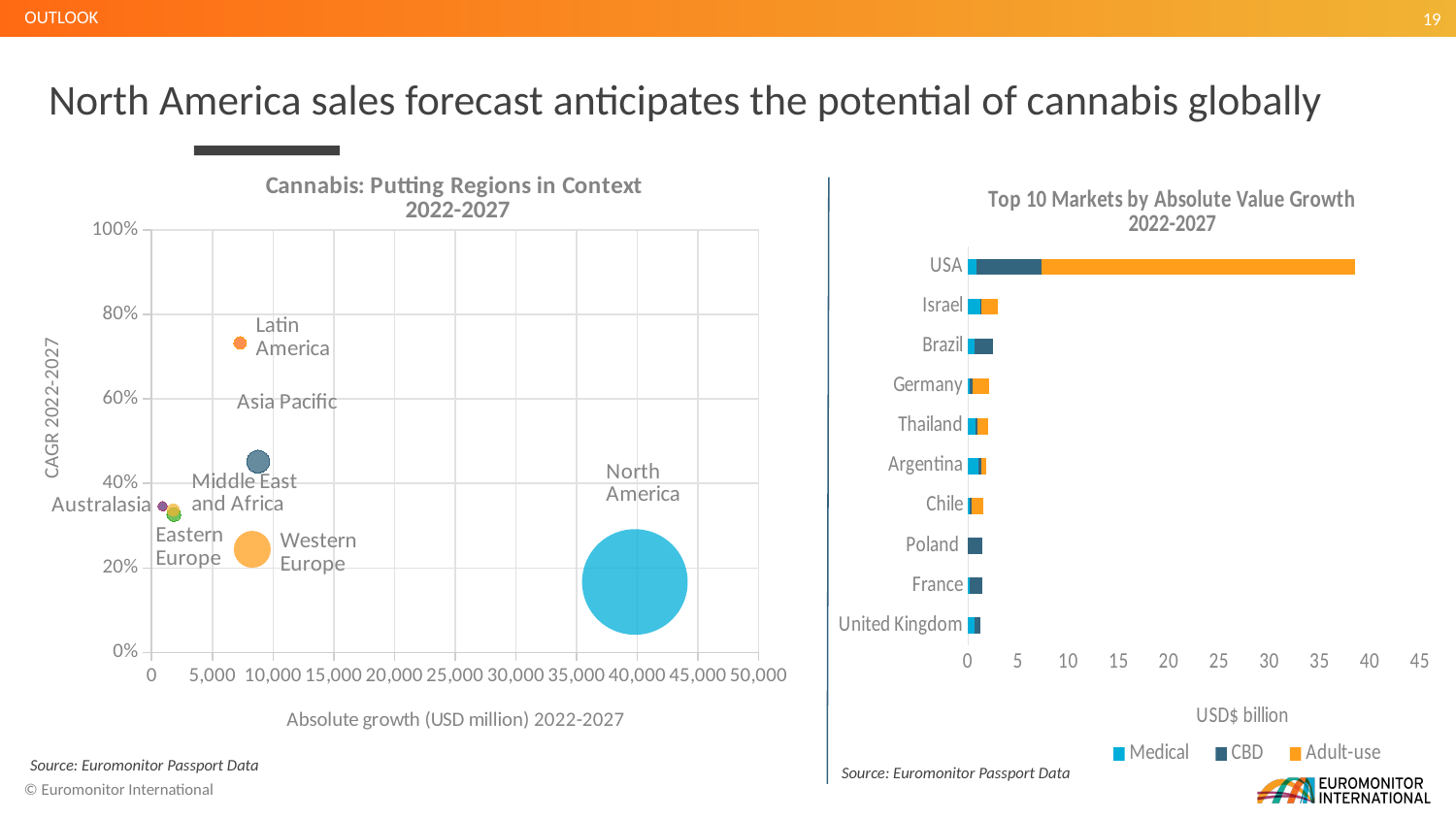
In the 'Top 10 Markets by Absolute Value Growth 2022-2027' chart, which market has the highest absolute value growth? USA In the 'Top 10 Markets by Absolute Value Growth 2022-2027' chart, how many markets are shown? 10 In the 'Top 10 Markets by Absolute Value Growth 2022-2027' chart, what unit is shown on the x axis? USD$ billion In the 'Top 10 Markets by Absolute Value Growth 2022-2027' chart, is the total value for Israel greater or less than 5? less In the 'Top 10 Markets by Absolute Value Growth 2022-2027' chart, is the total value for USA greater or less than 35? greater What kind of chart is the 'Cannabis: Putting Regions in Context 2022-2027' chart? Bubble chart In the 'Cannabis: Putting Regions in Context 2022-2027' chart, which region has the highest CAGR 2022-2027? Latin America In the 'Cannabis: Putting Regions in Context 2022-2027' chart, is the absolute growth for North America greater or less than 35,000? greater In the 'Top 10 Markets by Absolute Value Growth 2022-2027' chart, how many series does the legend list? 3 In the 'Top 10 Markets by Absolute Value Growth 2022-2027' chart, which is larger, the total for USA or the total for Brazil? USA In the 'Cannabis: Putting Regions in Context 2022-2027' chart, how many regions are plotted? 7 What kind of chart is the 'Top 10 Markets by Absolute Value Growth 2022-2027' chart? Stacked bar chart